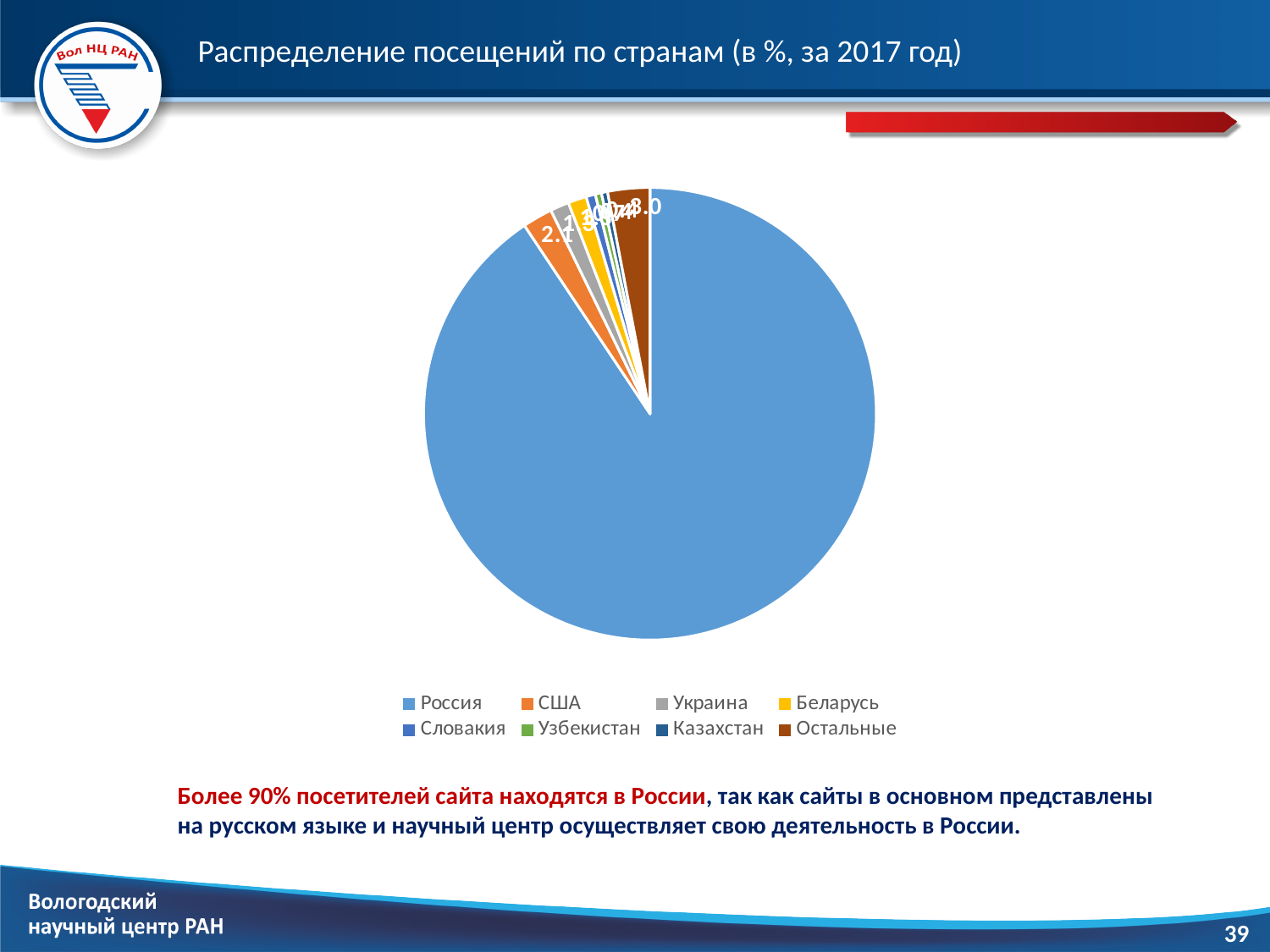
What is the title of the chart? Распределение посещений по странам (в %, за 2017 год) Which legend entry comes last in the pie chart legend? Остальные How many categories does the legend of the pie chart list? 8 What colour is the slice for Россия in the pie chart? blue What kind of chart is shown on the slide? pie chart Which slice is larger, Россия or США? Россия Which country has the largest slice of the pie chart? Россия Which slice is larger, Остальные or Словакия? Остальные Which slice is larger, США or Украина? США What is the value shown for США in the pie chart? 2.1